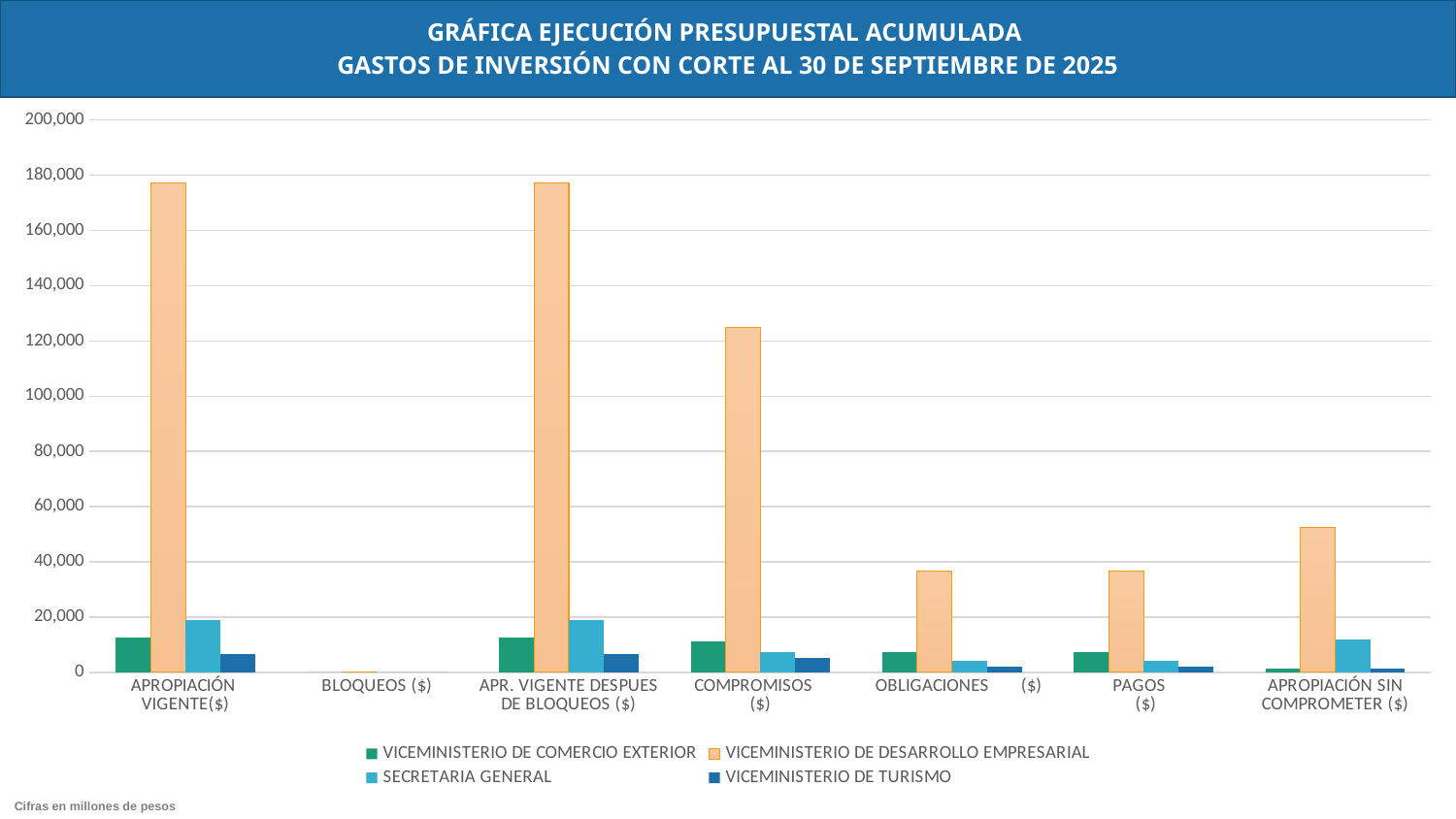
In the APROPIACIÓN VIGENTE($) category, which is larger: SECRETARIA GENERAL or VICEMINISTERIO DE TURISMO? SECRETARIA GENERAL Is the value for VICEMINISTERIO DE DESARROLLO EMPRESARIAL in APROPIACIÓN SIN COMPROMETER ($) greater or less than 40,000? greater For VICEMINISTERIO DE DESARROLLO EMPRESARIAL, which is larger: COMPROMISOS ($) or OBLIGACIONES ($)? COMPROMISOS ($) How many series does the legend list? 4 How many categories are shown on the x axis of the chart? 7 Is the value for VICEMINISTERIO DE DESARROLLO EMPRESARIAL in OBLIGACIONES ($) greater or less than 40,000? less Is the value for VICEMINISTERIO DE DESARROLLO EMPRESARIAL in APROPIACIÓN VIGENTE($) greater or less than 160,000? greater What kind of chart is shown on the slide? Bar chart For the VICEMINISTERIO DE DESARROLLO EMPRESARIAL series, which category has the lowest value? BLOQUEOS ($) What is the title of the chart? GRÁFICA EJECUCIÓN PRESUPUESTAL ACUMULADA GASTOS DE INVERSIÓN CON CORTE AL 30 DE SEPTIEMBRE DE 2025 Which series has the highest value in the COMPROMISOS ($) category? VICEMINISTERIO DE DESARROLLO EMPRESARIAL